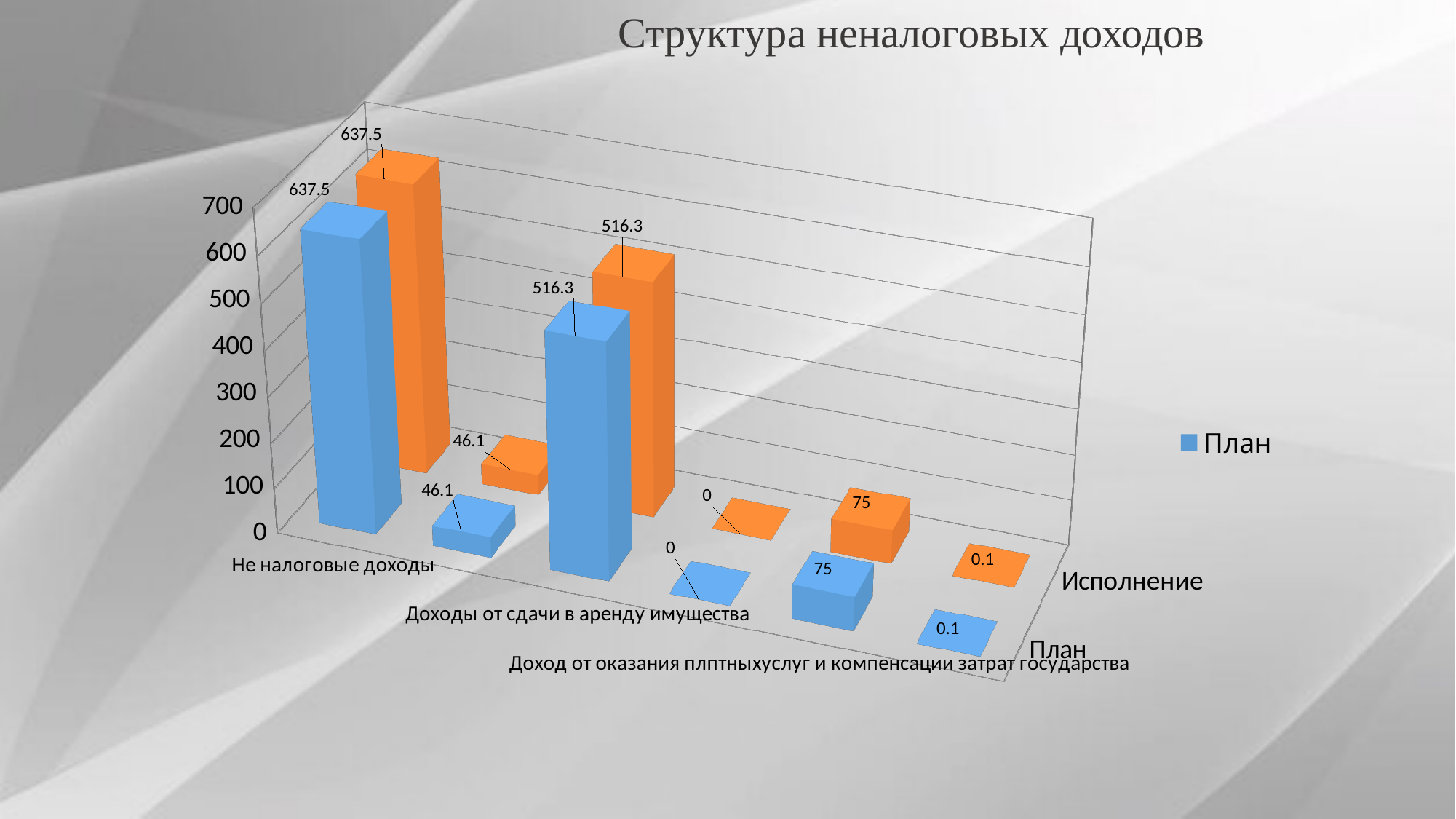
What is the difference between the План values for Не налоговые доходы and Доходы от сдачи в аренду имущества? 121.2 What is the Исполнение value for Не налоговые доходы? 637.5 How many bars does the План series contain? 6 Which category has the highest План value? Не налоговые доходы What is the План value for Доходы от сдачи в аренду имущества? 516.3 What is the title of the chart? Структура неналоговых доходов What colour are the bars of the План series? blue What is the Исполнение value for Доход от оказания плптныхуслуг и компенсации затрат государства? 75 What kind of chart is shown on the slide? bar chart Is the Исполнение value for Доходы от сдачи в аренду имущества greater or less than 500? greater What is the План value for Не налоговые доходы? 637.5 Which is larger: the План value for Доходы от сдачи в аренду имущества or the План value for Доход от оказания плптныхуслуг и компенсации затрат государства? Доходы от сдачи в аренду имущества